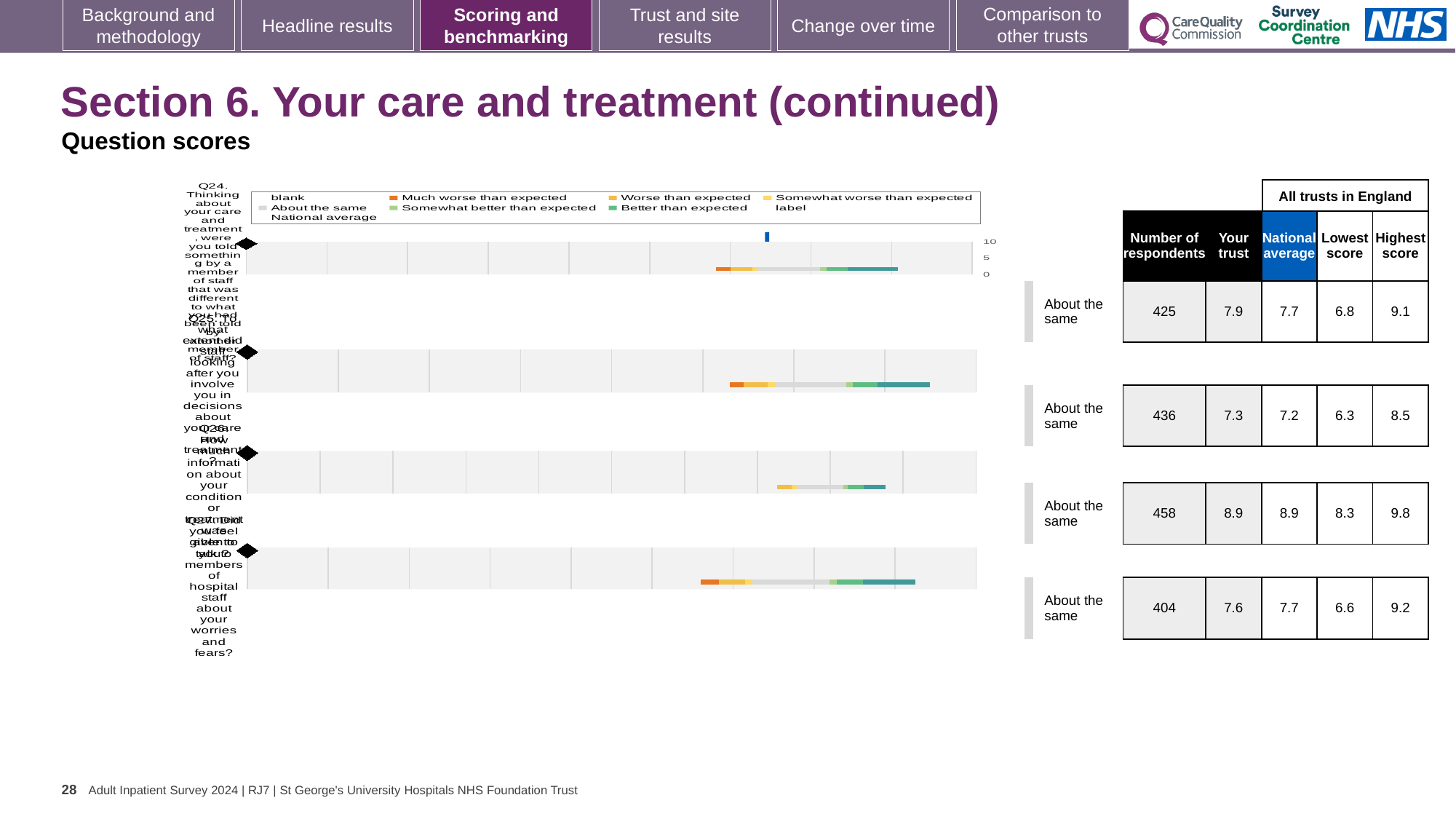
Which legend category is shown in grey? About the same What is the 'Your trust' score for Q24? 7.9 For Q27, which is larger: the trust's score or the national average? national average For Q24, what is the difference between the highest score and the lowest score across all trusts in England? 2.3 What is the national average score for Q27? 7.7 How many entries does the chart legend list? 9 Which question has the highest 'Your trust' score? Q26 How many respondents answered Q25? 436 Is the trust's score for Q26 greater or less than 5 on the chart axis? greater Which question has the lowest 'Your trust' score? Q25 How many questions (Q24 to Q27) have a benchmarking chart on this slide? 4 What kind of chart is used to show the question scores on this slide? bar chart